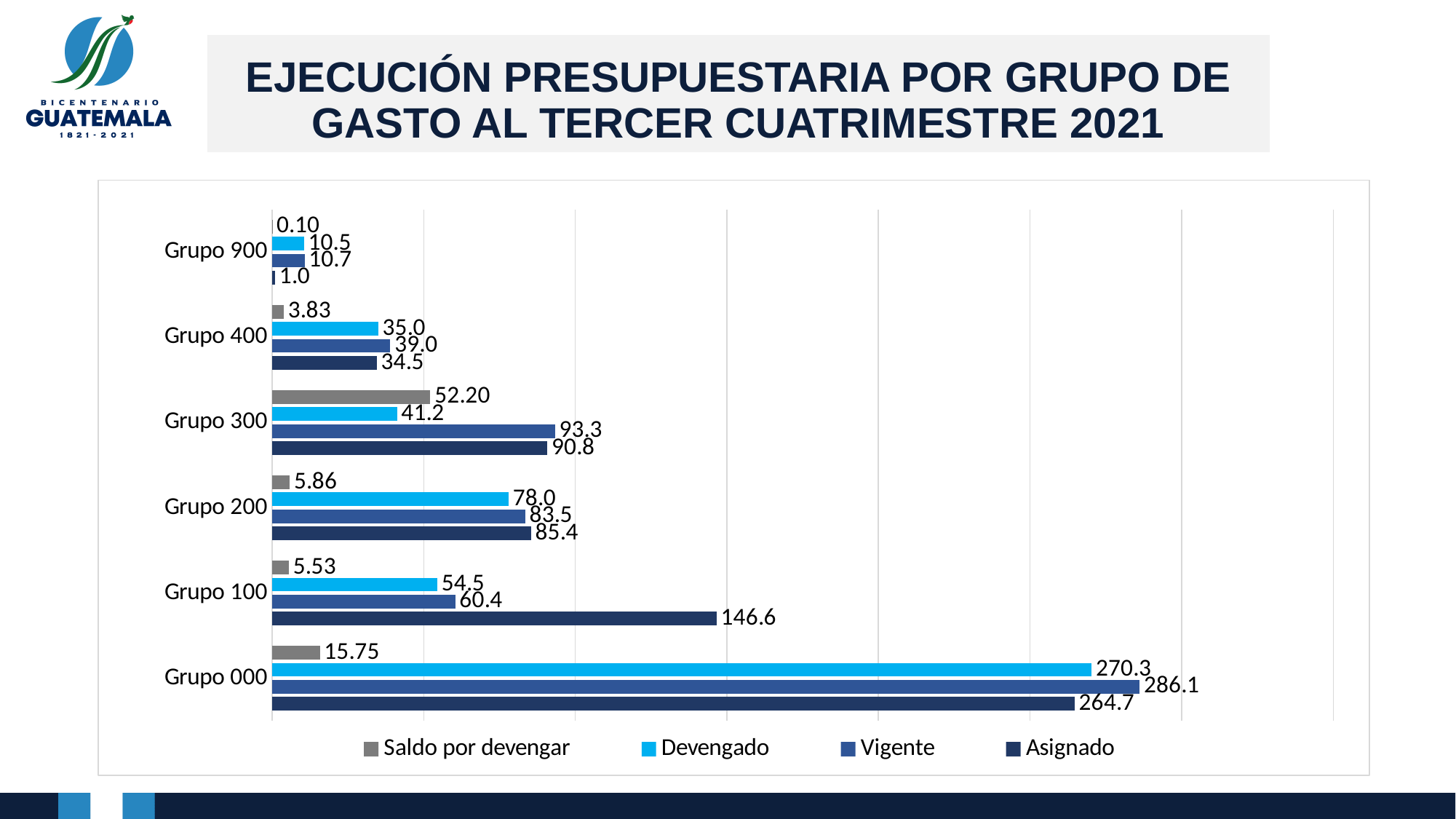
Which is larger for Grupo 200, the Asignado value or the Vigente value? Asignado Which group has the highest Vigente value? Grupo 000 What is the Asignado value for Grupo 100? 146.6 What is the difference between the Vigente and Devengado values for Grupo 300? 52.1 How many series does the legend list? 4 How many groups are shown on the chart? 6 What is the Saldo por devengar value for Grupo 300? 52.20 What kind of chart is shown on the slide? Bar chart What is the Vigente value for Grupo 400? 39.0 Which series is shown in grey in the legend? Saldo por devengar What is the Devengado value for Grupo 000? 270.3 Which group has the lowest Asignado value? Grupo 900